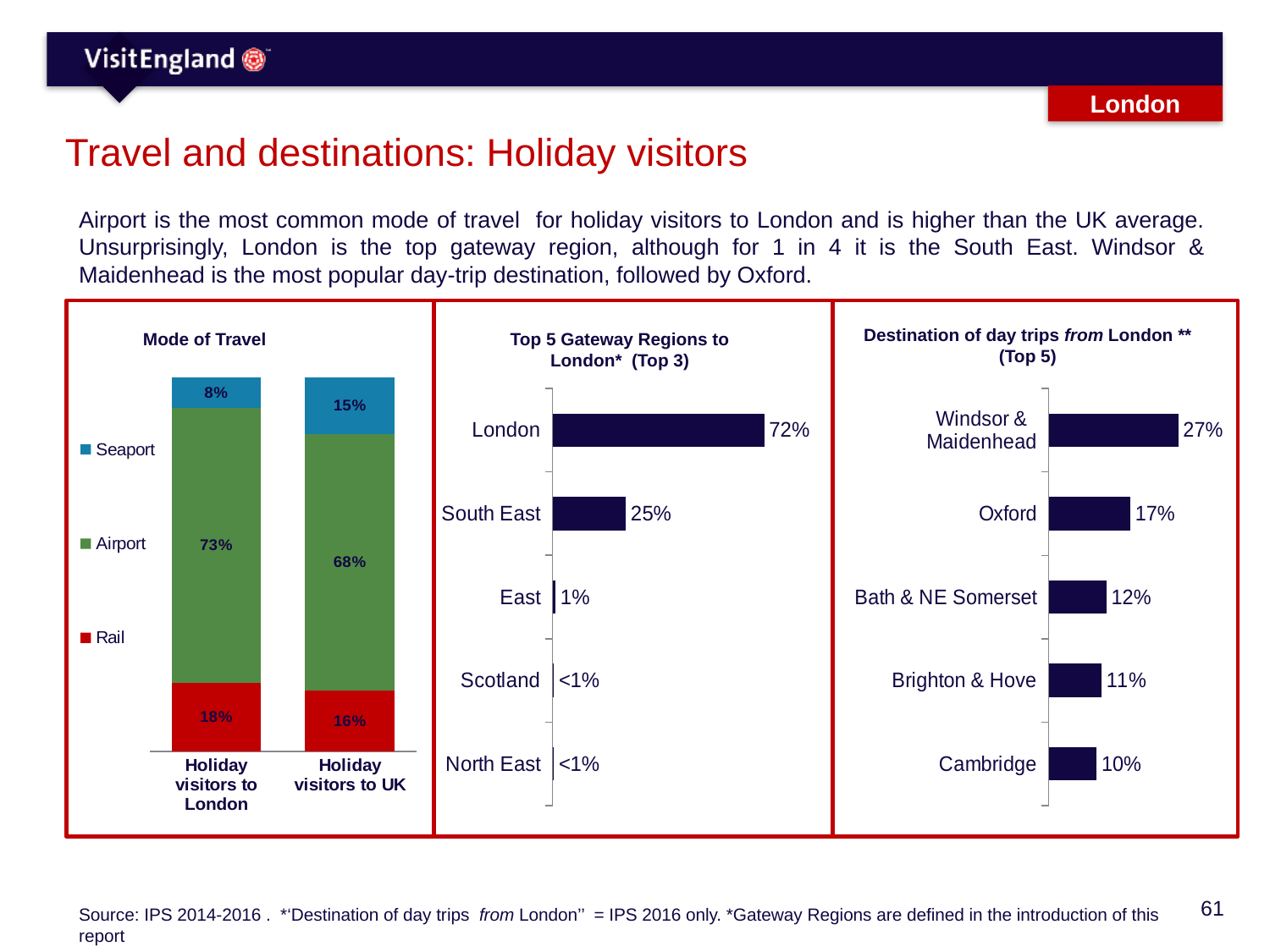
In the Mode of Travel chart, which mode of travel is shown in green? Airport In the Top 5 Gateway Regions to London chart, how many regions are shown? 5 In the Destination of day trips from London chart, which destination has the lowest value? Cambridge In the Top 5 Gateway Regions to London chart, what is the difference between London and South East? 47% In the Destination of day trips from London chart, what is the value for Bath & NE Somerset? 12% In the Mode of Travel chart, how many series does the legend list? 3 In the Mode of Travel chart, what is the difference between the Rail share for holiday visitors to London and for holiday visitors to UK? 2% In the Mode of Travel chart, what percentage of holiday visitors to London travel by Airport? 73% In the Mode of Travel chart, what percentage of holiday visitors to UK travel by Seaport? 15% In the Top 5 Gateway Regions to London chart, which region has the highest value? London In the Top 5 Gateway Regions to London chart, what is the value for South East? 25% What kind of chart is the Destination of day trips from London chart? Bar chart